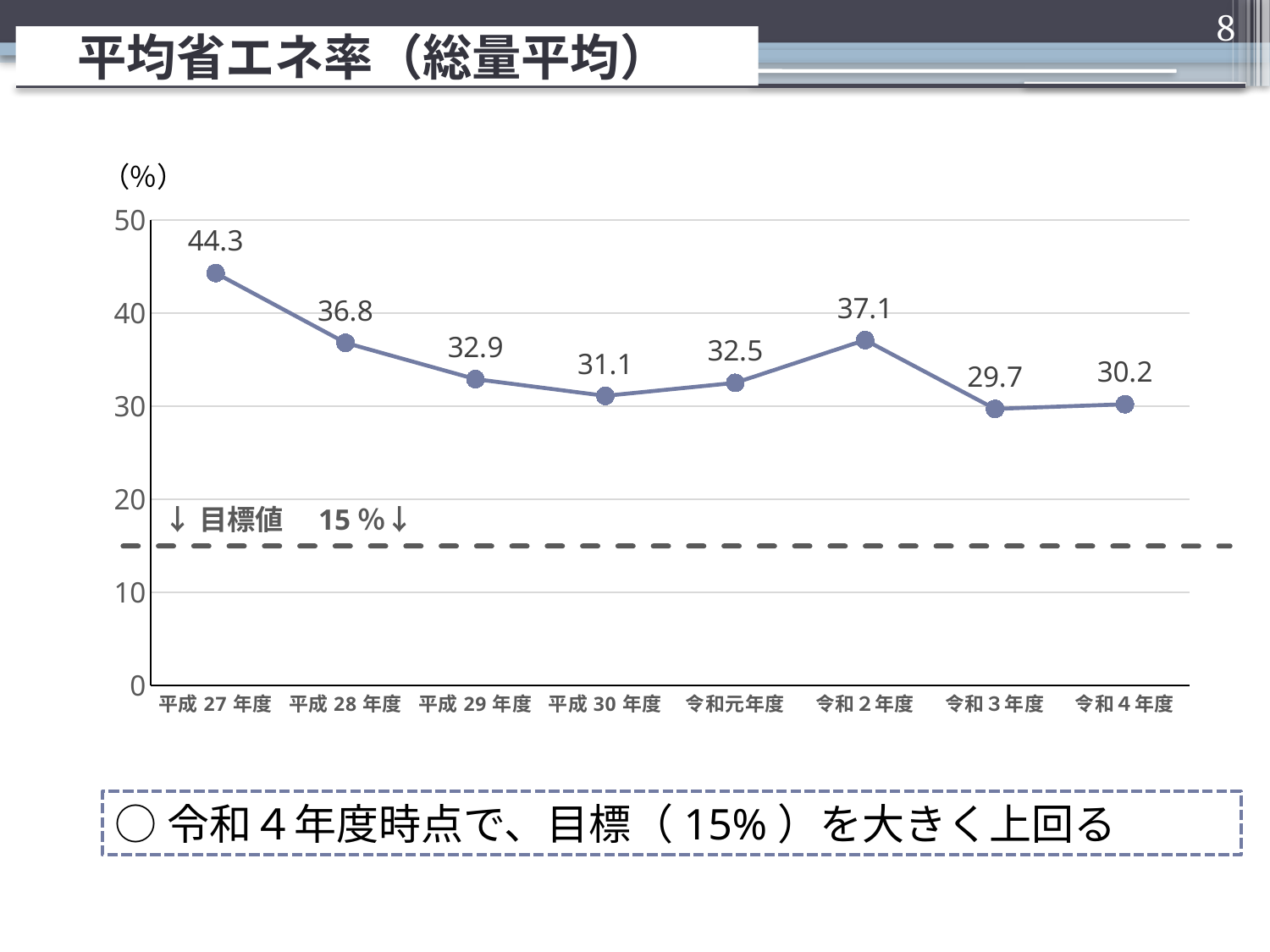
What is the value for 平成27年度? 44.3 What is the value for 令和2年度? 37.1 Which year has the highest value? 平成27年度 What target value (目標値) is marked by the dashed line on the chart? 15% What is the difference between the values for 平成27年度 and 平成28年度? 7.5 What is the value for 令和4年度? 30.2 How many years are plotted on the chart? 8 Do the values generally rise or fall from 平成27年度 to 令和4年度? fall What kind of chart is shown on the slide? line chart Which is larger, the value for 令和元年度 or the value for 令和2年度? 令和2年度 Is the value for 平成30年度 greater or less than 20? greater Which year has the lowest value? 令和3年度